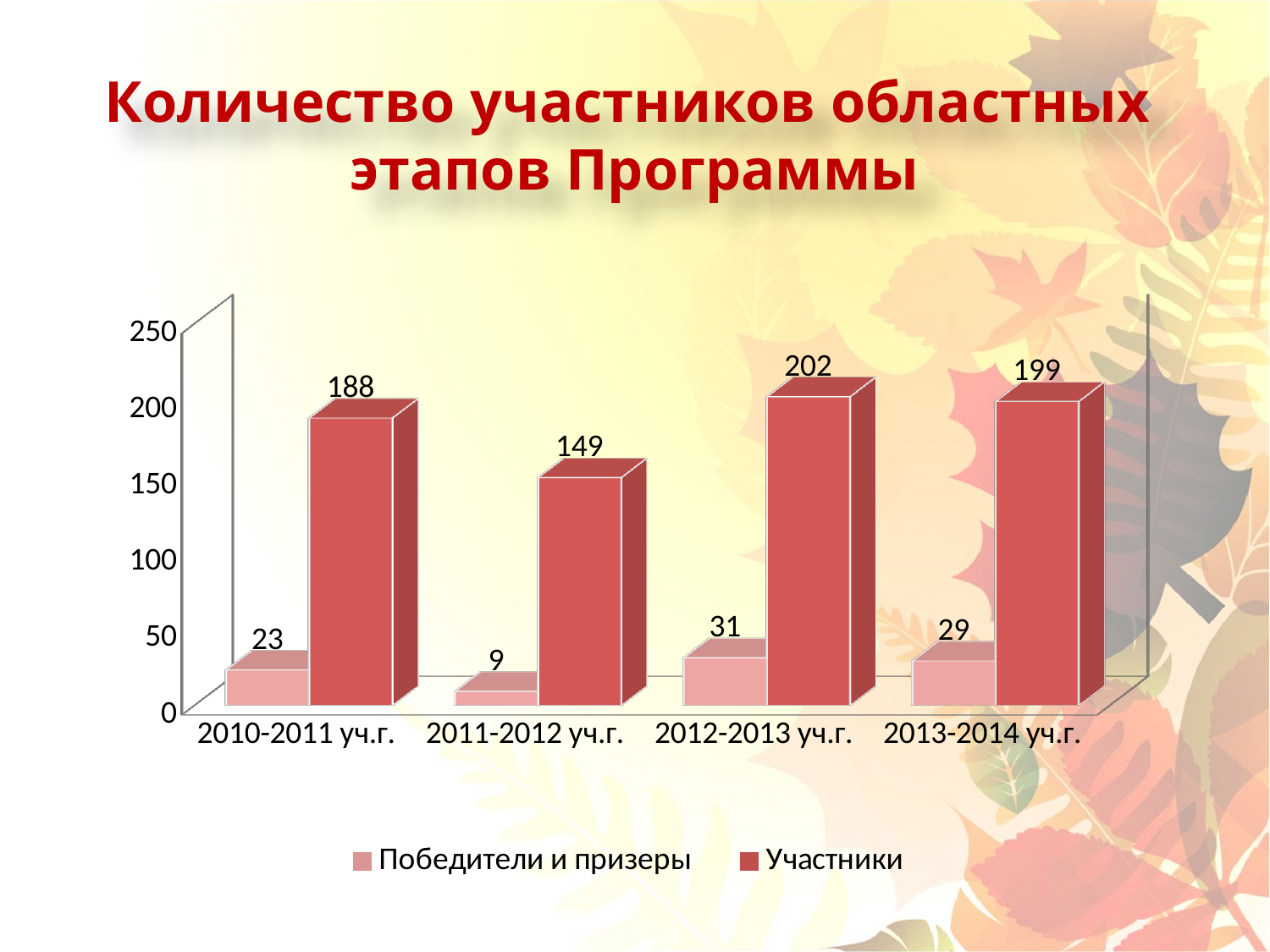
Which year has the lowest value for Победители и призеры? 2011-2012 уч.г. What is the difference between Участники in 2012-2013 уч.г. and 2011-2012 уч.г.? 53 Which is larger: Победители и призеры in 2010-2011 уч.г. or in 2012-2013 уч.г.? 2012-2013 уч.г. What is the value for Участники in 2012-2013 уч.г.? 202 How many series does the legend list? 2 What is the title of the slide? Количество участников областных этапов Программы What kind of chart is shown on the slide? bar chart What is the value for Победители и призеры in 2013-2014 уч.г.? 29 How many years are shown on the x axis? 4 Which year has the highest value for Участники? 2012-2013 уч.г. What is the value for Участники in 2010-2011 уч.г.? 188 What is the value for Победители и призеры in 2011-2012 уч.г.? 9